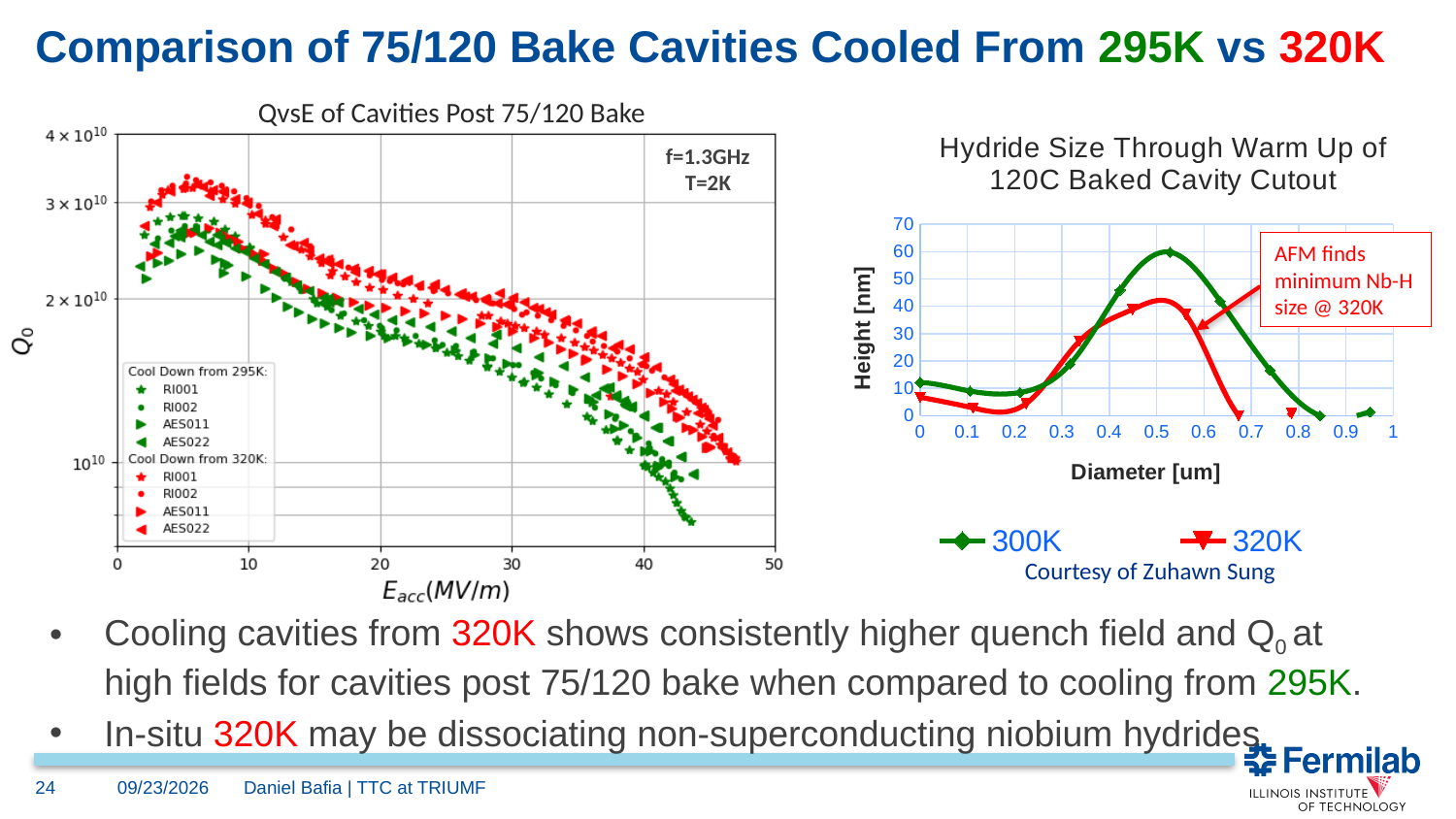
What kind of chart is the 'QvsE of Cavities Post 75/120 Bake' chart? scatter plot In the 'Hydride Size Through Warm Up of 120C Baked Cavity Cutout' chart, which series reaches the higher peak height, 300K or 320K? 300K What kind of chart is the 'Hydride Size Through Warm Up of 120C Baked Cavity Cutout' chart? line chart How many series does the legend of the 'Hydride Size Through Warm Up of 120C Baked Cavity Cutout' chart list? 2 In the 'Hydride Size Through Warm Up of 120C Baked Cavity Cutout' chart, is the peak height of the 300K series greater or less than 50 nm? greater What does the annotation box on the 'Hydride Size Through Warm Up of 120C Baked Cavity Cutout' chart say? AFM finds minimum Nb-H size @ 320K In the 'Hydride Size Through Warm Up of 120C Baked Cavity Cutout' chart, is the peak height of the 320K series greater or less than 50 nm? less How many series does the legend of the 'QvsE of Cavities Post 75/120 Bake' chart list? 8 In the 'QvsE of Cavities Post 75/120 Bake' chart, does Q0 rise or fall as Eacc increases beyond about 10 MV/m? fall In the 'QvsE of Cavities Post 75/120 Bake' chart, which cool-down group reaches higher Q0 values, 295K (green) or 320K (red)? 320K (red) What is the y-axis label of the 'Hydride Size Through Warm Up of 120C Baked Cavity Cutout' chart? Height [nm] In the 'Hydride Size Through Warm Up of 120C Baked Cavity Cutout' chart, is the 320K height at a diameter of 0.7 um greater or less than 10 nm? less